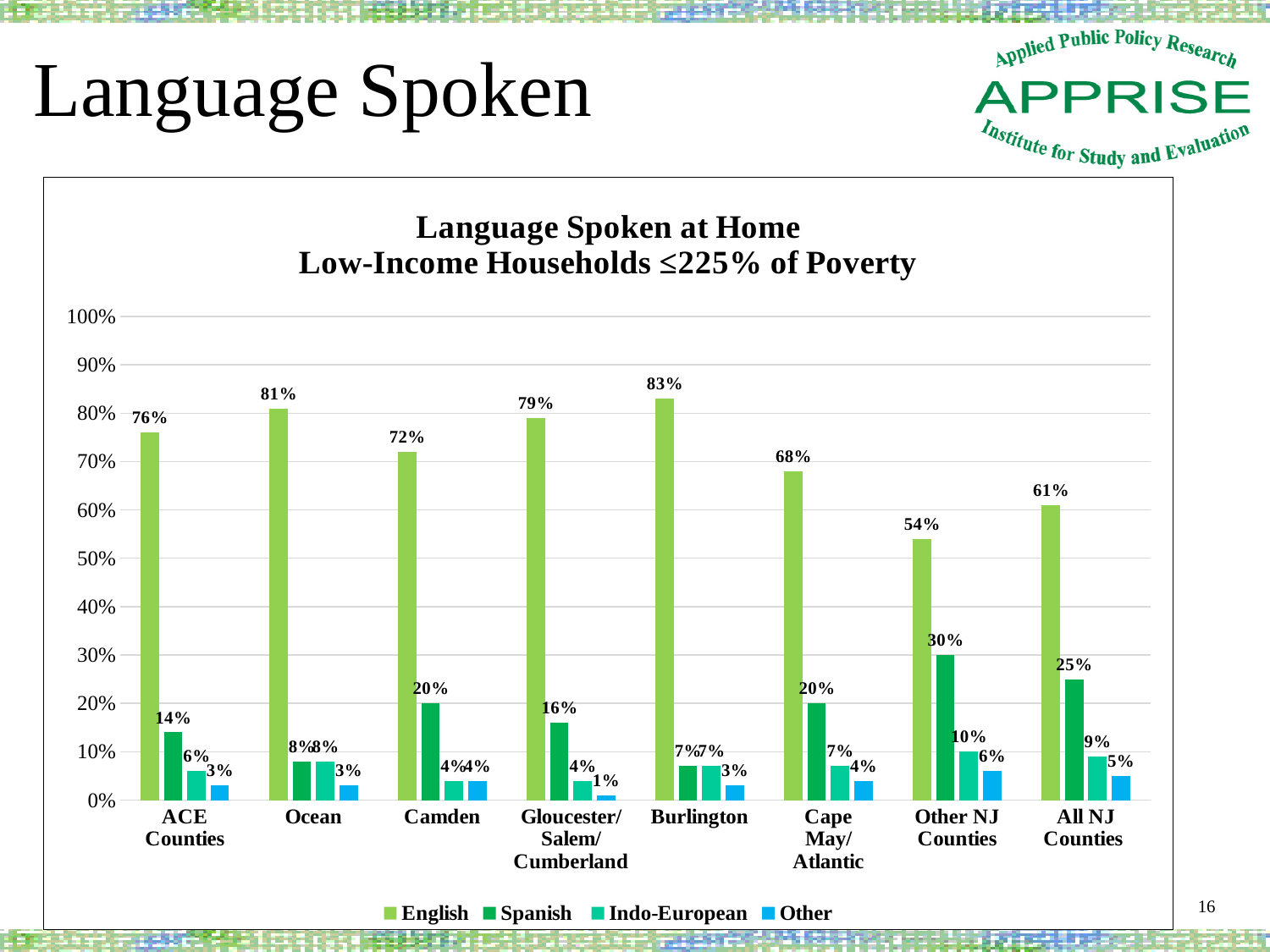
What percentage of low-income households in Burlington speak English at home? 83% Is the English value for Cape May/Atlantic greater or less than 70%? less What is the difference between the English values for Ocean and Camden? 9% Which is larger, the Spanish value for ACE Counties or the Spanish value for Camden? Camden How many categories are shown on the x axis? 8 What is the Indo-European value for All NJ Counties? 9% Which category has the highest English value? Burlington Which category has the lowest English value? Other NJ Counties How many series does the legend list? 4 What kind of chart is shown on the slide? bar chart What is the title of the chart? Language Spoken at Home Low-Income Households ≤225% of Poverty What is the Spanish value for Other NJ Counties? 30%